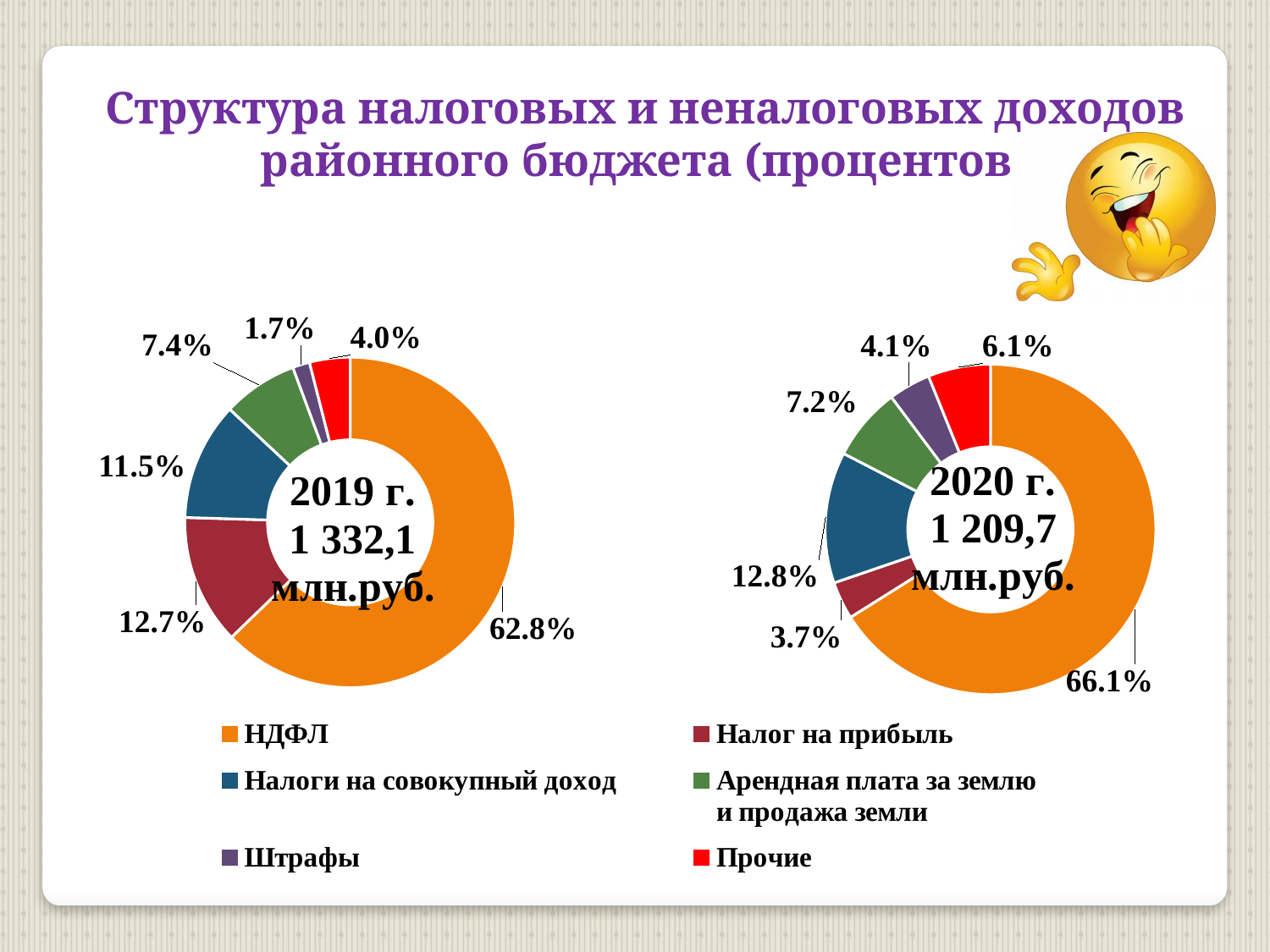
What total amount in млн.руб. is shown in the centre of the 2020 chart? 1 209,7 млн.руб. In the 2019 chart, which category has the largest share? НДФЛ In the 2019 chart, what share does Штрафы have? 1.7% What type of chart is used on this slide? Doughnut (pie) chart In the 2019 chart, what share does НДФЛ have? 62.8% In the 2020 chart, which is larger: the share of Прочие or the share of Штрафы? Прочие In the 2020 chart, what share does Налог на прибыль have? 3.7% In the 2020 chart, which category has the smallest share? Налог на прибыль In the 2020 chart, what share does Налоги на совокупный доход have? 12.8% In the 2019 chart, which category has the smallest share? Штрафы What is the difference between the НДФЛ share in 2020 and in 2019? 3.3% How many categories does the legend list? 6